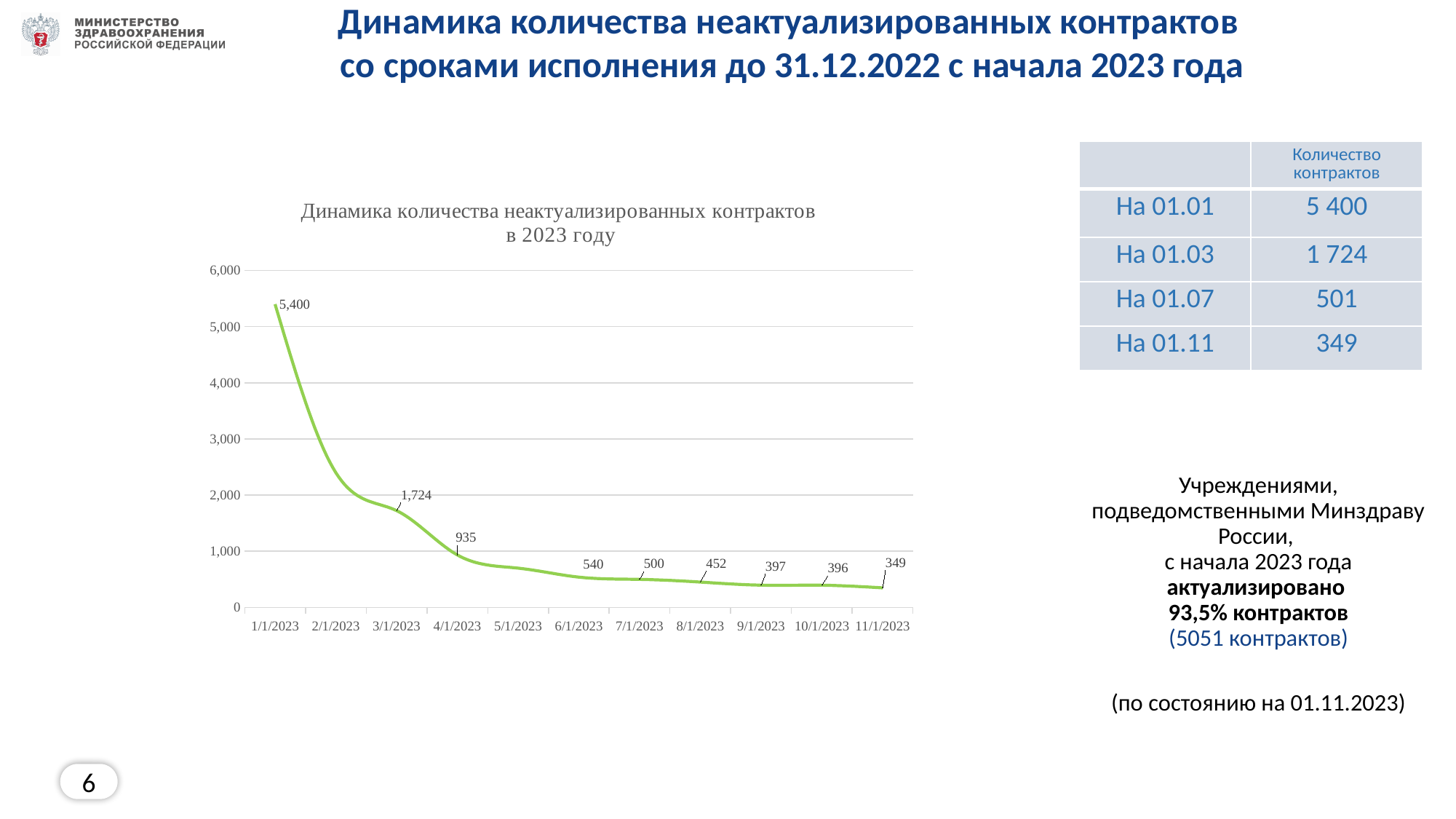
Do the values rise or fall along the x axis? fall What is the value for 1/1/2023? 5,400 What is the value for 3/1/2023? 1,724 What is the value for 8/1/2023? 452 Is the value for 5/1/2023 greater or less than 1,000? less Which date has the highest value? 1/1/2023 What is the value for 4/1/2023? 935 Which date has the lowest value? 11/1/2023 Which is larger, the value for 6/1/2023 or the value for 7/1/2023? 6/1/2023 What type of chart is shown on the slide? line chart What is the value for 11/1/2023? 349 What is the difference between the values for 1/1/2023 and 3/1/2023? 3,676